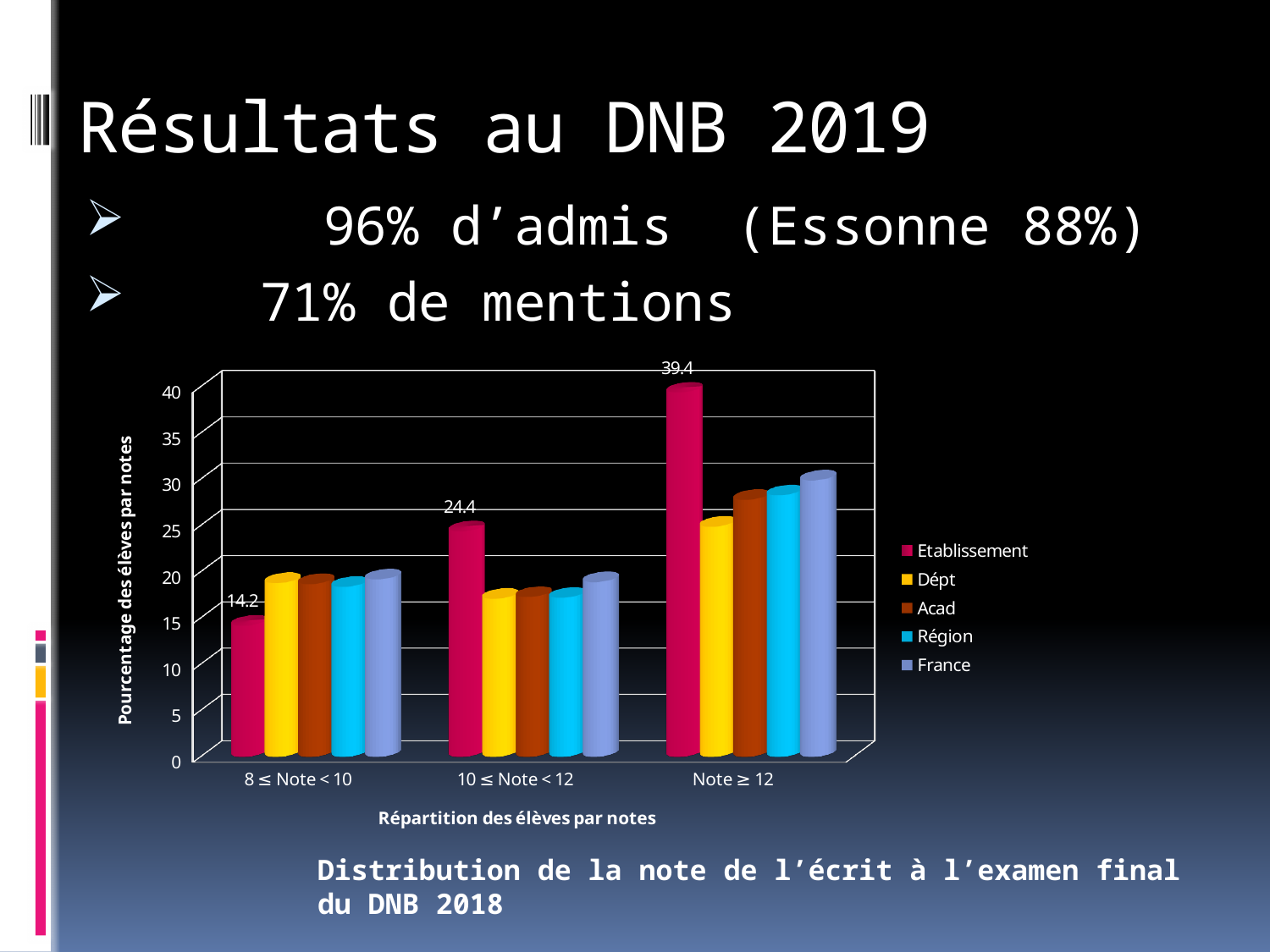
In which category is the Etablissement value highest? Note ≥ 12 How many series does the legend list? 5 Is the value for France in the "Note ≥ 12" category greater or less than 25? greater What is the value for Etablissement in the "10 ≤ Note < 12" category? 24.4 What is the value for Etablissement in the "8 ≤ Note < 10" category? 14.2 What is the value for Etablissement in the "Note ≥ 12" category? 39.4 In which category is the Etablissement value lowest? 8 ≤ Note < 10 Do the Etablissement values rise or fall from "8 ≤ Note < 10" to "Note ≥ 12"? rise What is the difference between the Etablissement values for "Note ≥ 12" and "8 ≤ Note < 10"? 25.2 How many categories are shown on the x axis? 3 In the "8 ≤ Note < 10" category, which is larger: Etablissement or France? France In the "Note ≥ 12" category, which is larger: Etablissement or Dépt? Etablissement